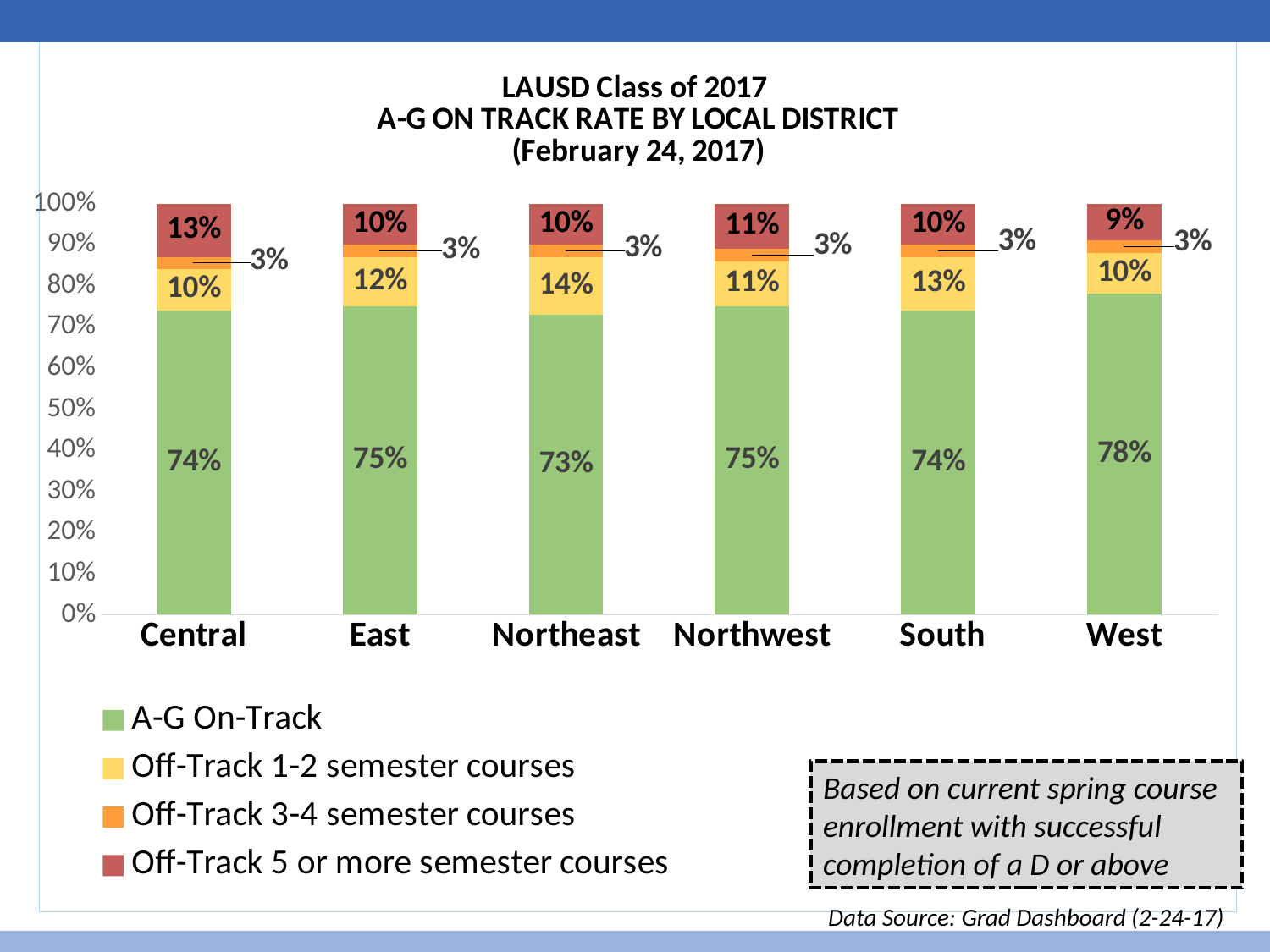
Which local district has the lowest A-G On-Track rate? Northeast Which series is shown in green in the legend? A-G On-Track Which local district has the highest A-G On-Track rate? West What is the Off-Track 3-4 semester courses value for South? 3% What kind of chart is shown on the slide? Stacked bar chart What is the A-G On-Track rate for the West local district? 78% How many series does the legend list? 4 Which local district has the highest Off-Track 1-2 semester courses percentage? Northeast What percentage of the Central local district is Off-Track 5 or more semester courses? 13% What is the difference between the A-G On-Track rates of West and Northeast? 5 percentage points How many local districts are shown on the chart? 6 Which has a larger Off-Track 1-2 semester courses percentage, East or Northeast? Northeast